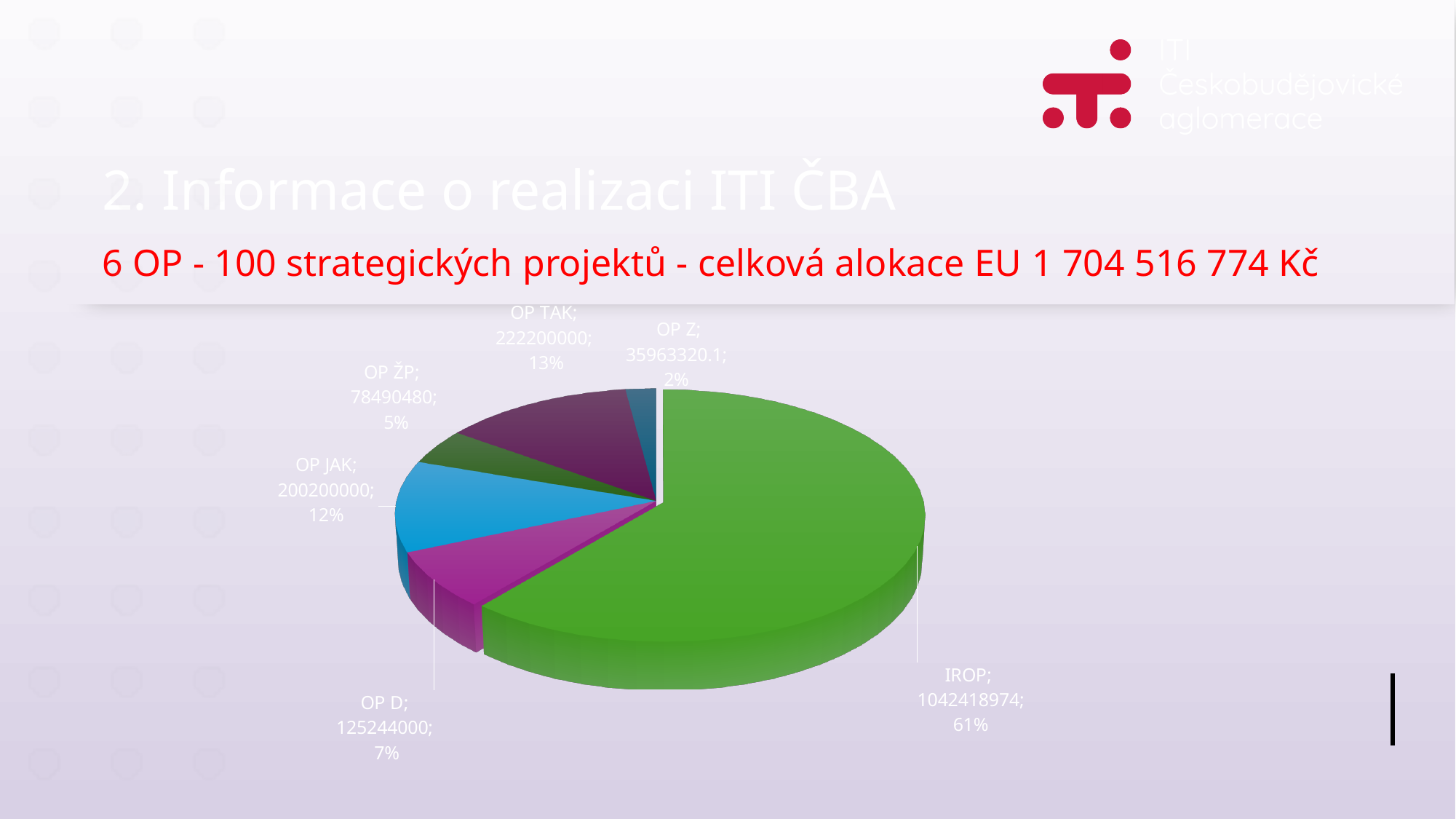
What percentage share of the pie does OP JAK have? 12% What is the value shown for IROP? 1042418974 What is the difference between the values for OP TAK and OP JAK? 22000000 Which category has the smallest slice of the pie? OP Z How many slices does the pie chart have? 6 What is the value shown for OP Z? 35963320.1 Which category has the largest slice of the pie? IROP What percentage share of the pie does OP D have? 7% What kind of chart is shown on the slide? pie chart What is the value shown for OP TAK? 222200000 What colour is the IROP slice? green Which is larger, the value for OP TAK or the value for OP JAK? OP TAK